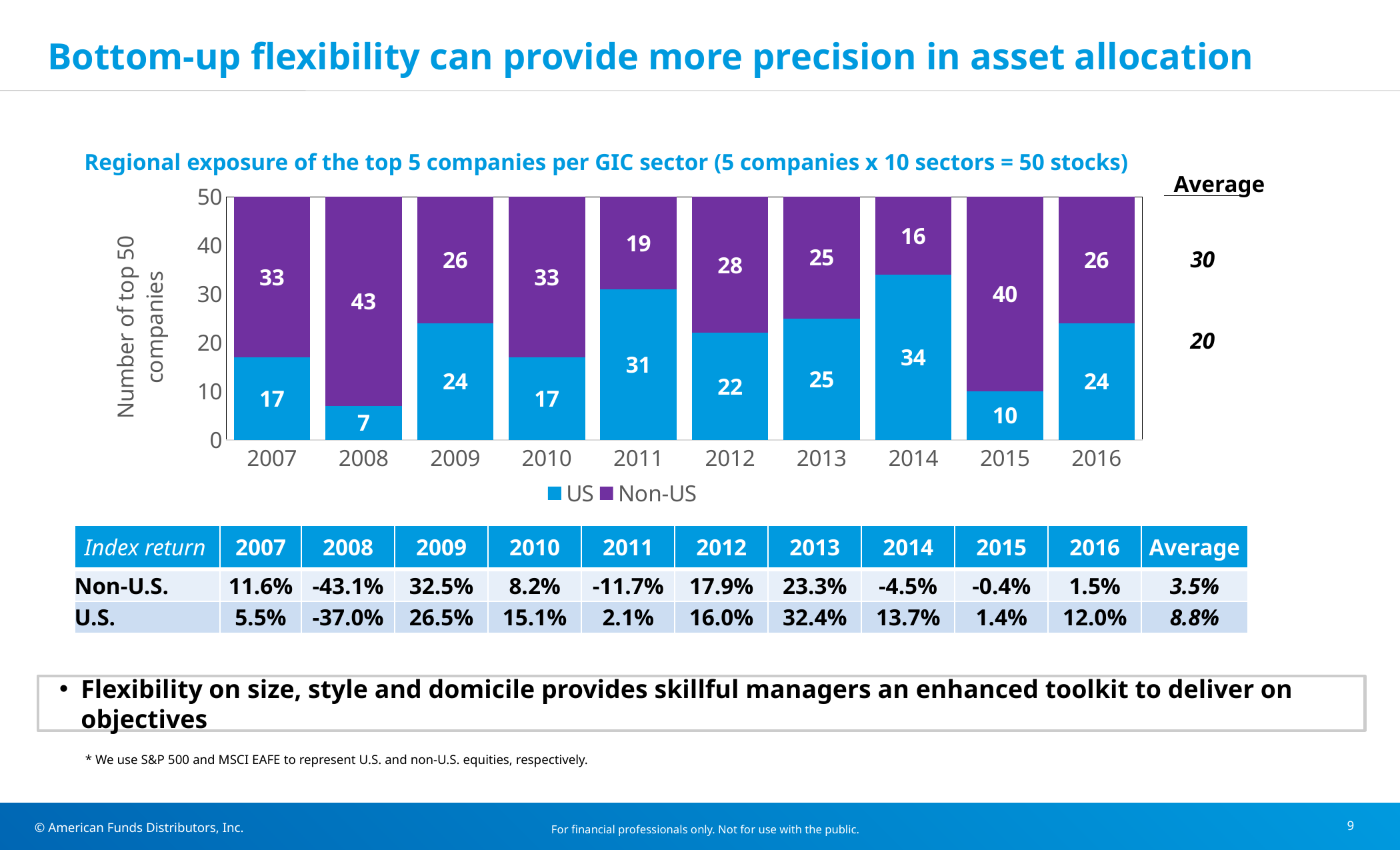
How many series does the legend list? 2 What is the US value for 2008? 7 What kind of chart is shown? Stacked bar chart What is the US value for 2011? 31 Which year has the lowest Non-US value? 2014 How many years are shown on the x axis? 10 What is the Non-US value for 2015? 40 In 2012, which is larger, the US value or the Non-US value? Non-US Which year has the highest US value? 2014 What is the total of the stacked bar for 2013? 50 What is the difference between the Non-US and US values in 2008? 36 What is the y-axis label of the chart? Number of top 50 companies